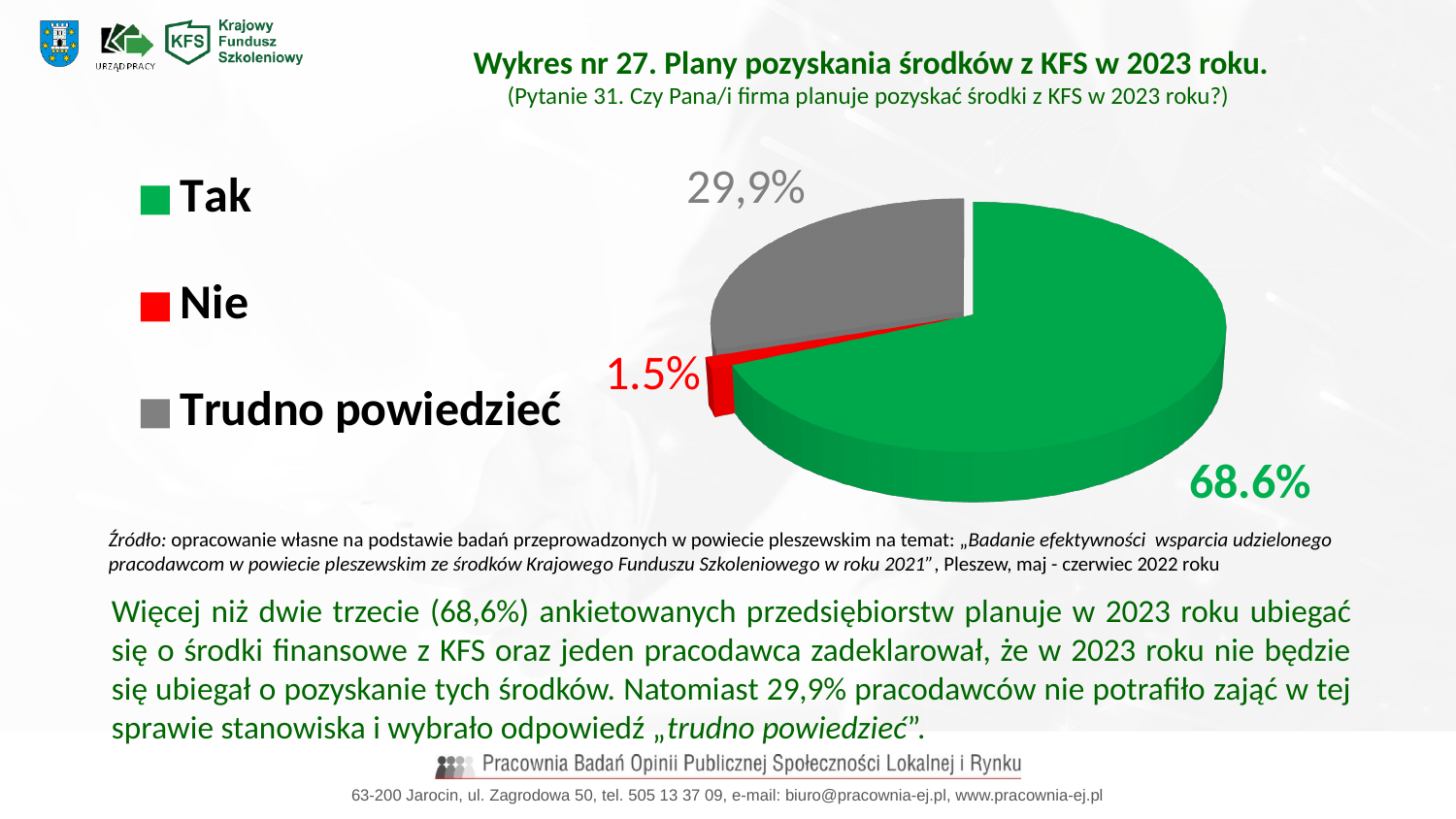
Which category has the smallest slice of the pie? Nie Which category has the largest slice of the pie? Tak What colour is the "Tak" slice of the pie? green What share of the pie does the "Trudno powiedzieć" slice represent? 29,9% What kind of chart is shown on the slide? pie chart What share of the pie does the "Nie" slice represent? 1.5% What is the title of the chart? Wykres nr 27. Plany pozyskania środków z KFS w 2023 roku. How many categories does the pie chart show? 3 What share of the pie does the "Tak" slice represent? 68.6% How many entries does the legend list? 3 Is the share for "Trudno powiedzieć" greater or less than 50%? less Which slice is larger, "Nie" or "Trudno powiedzieć"? Trudno powiedzieć